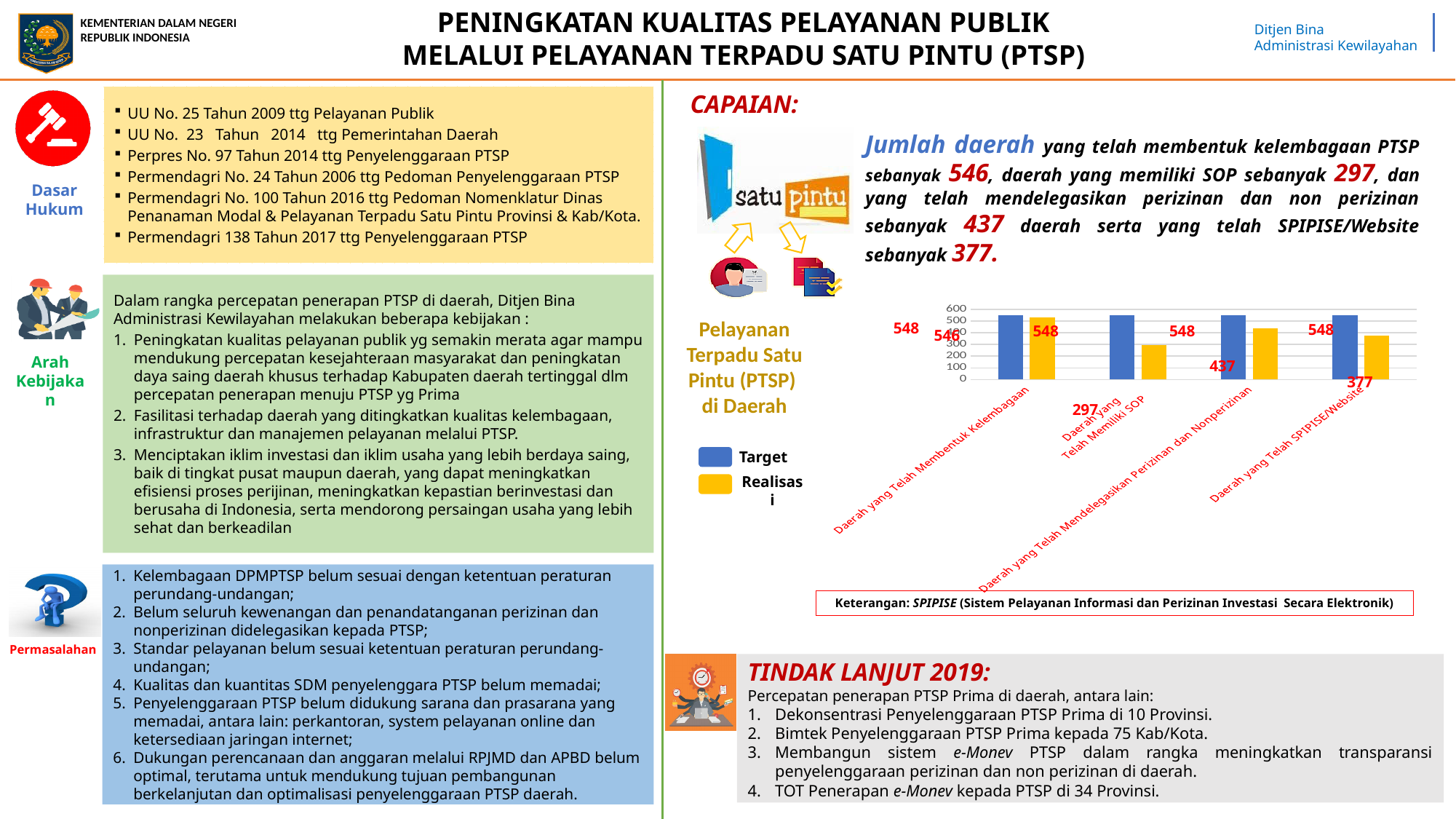
What is the Target value for Daerah yang Telah Mendelegasikan Perizinan dan Nonperizinan? 548 How many series does the chart legend list? 2 What is the Realisasi value for Daerah yang Telah Memiliki SOP? 297 Which category has the highest Realisasi value? Daerah yang Telah Membentuk Kelembagaan Is the Realisasi value for Daerah yang Telah Mendelegasikan Perizinan dan Nonperizinan larger or smaller than the Realisasi value for Daerah yang Telah SPIPISE/Website? larger How many categories are plotted on the chart? 4 What is the Realisasi value for Daerah yang Telah Membentuk Kelembagaan? 546 Which category has the lowest Realisasi value? Daerah yang Telah Memiliki SOP What is the difference between the Target and Realisasi values for Daerah yang Telah Memiliki SOP? 251 What is the Realisasi value for Daerah yang Telah SPIPISE/Website? 377 What kind of chart is shown on the slide? bar chart Which series is shown in yellow in the chart legend? Realisasi